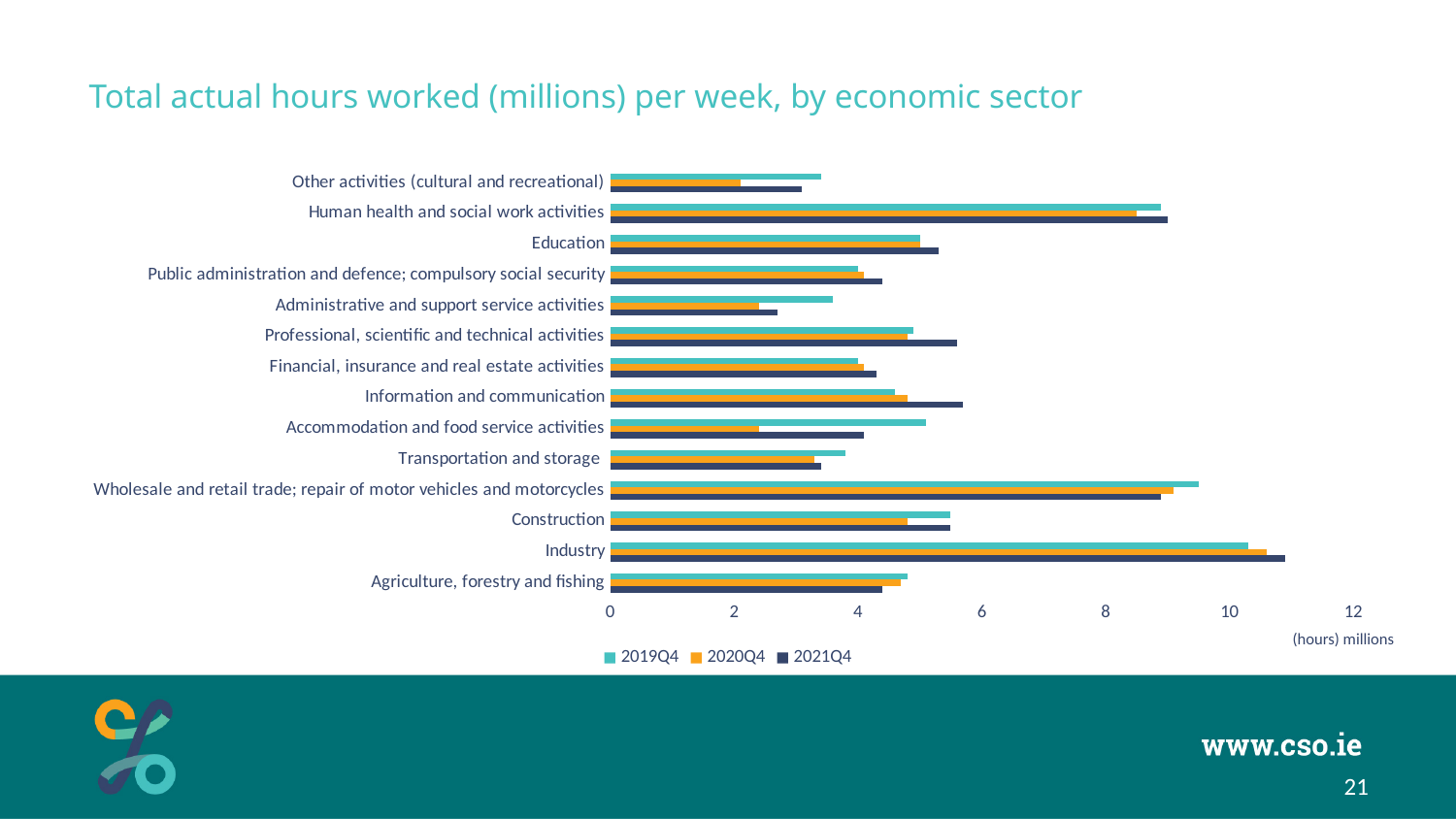
Is the 2021Q4 value for Industry greater or less than 10? greater Which economic sector has the highest total actual hours worked in 2021Q4? Industry Is the 2019Q4 value for Wholesale and retail trade; repair of motor vehicles and motorcycles greater or less than 8? greater Which economic sector has the highest total actual hours worked in 2019Q4? Industry How many series does the legend list? 3 For Information and communication, which is larger: the 2019Q4 value or the 2021Q4 value? 2021Q4 What are the three series listed in the legend? 2019Q4, 2020Q4, 2021Q4 Is the 2021Q4 value for Administrative and support service activities greater or less than 4? less How many economic sectors are shown on the chart? 14 What kind of chart is shown on the slide? Bar chart For Accommodation and food service activities, which is larger: the 2019Q4 value or the 2020Q4 value? 2019Q4